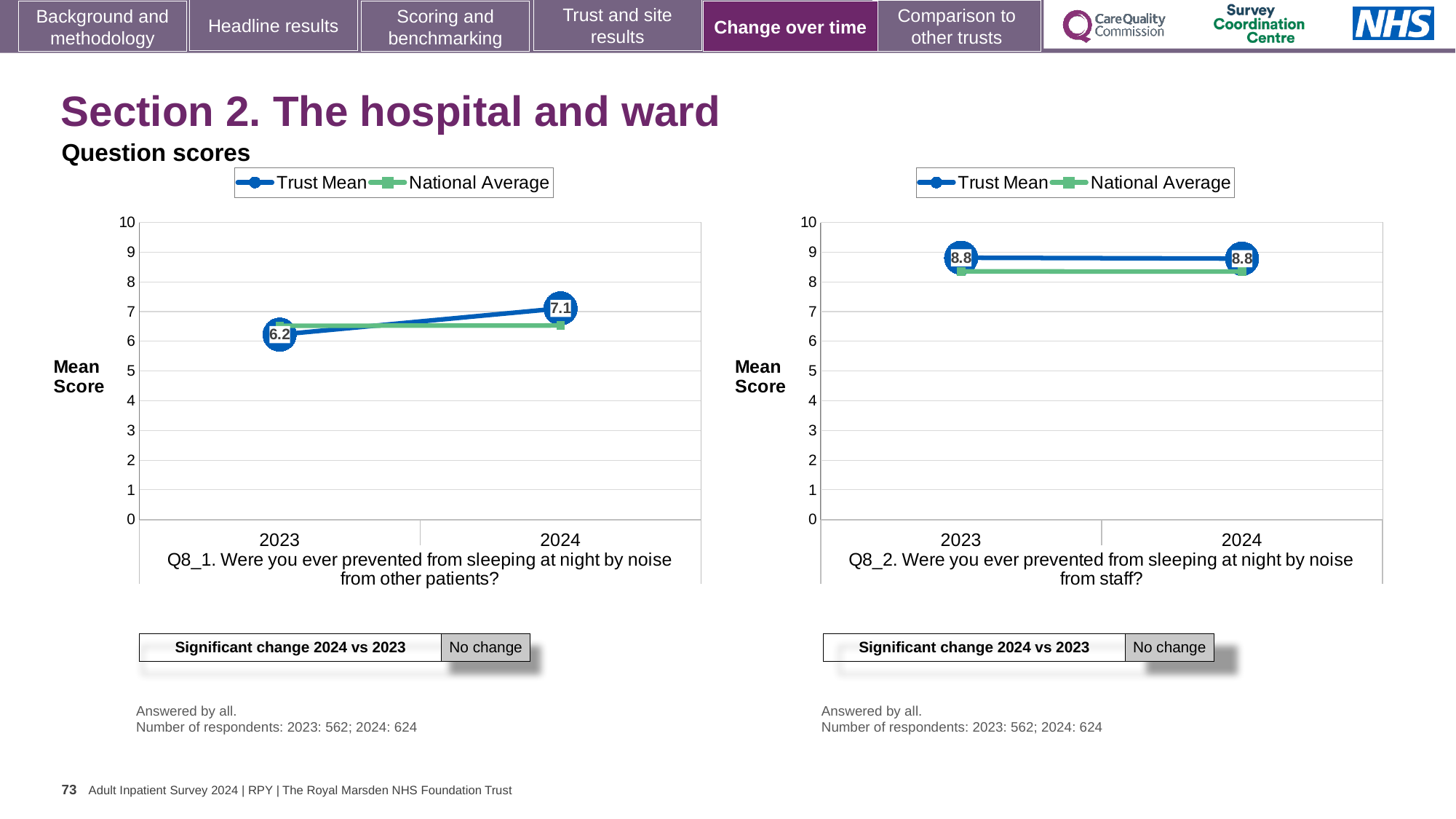
In the Q8_1 chart (left), which is larger in 2024, the Trust Mean or the National Average? Trust Mean How many series does the legend of the Q8_2 chart (right) list? 2 In the Q8_2 chart (right), what is the Trust Mean score for 2024? 8.8 In the Q8_1 chart (left), does the Trust Mean rise or fall from 2023 to 2024? rise In the Q8_1 chart (left), what is the Trust Mean score for 2023? 6.2 In the Q8_1 chart (left), is the National Average for 2023 greater or less than 6? greater What kind of chart is the Q8_1 chart (left)? line chart In the Q8_1 chart (left), by how much did the Trust Mean change from 2023 to 2024? 0.9 In the Q8_1 chart (left), what is the Trust Mean score for 2024? 7.1 In the Q8_2 chart (right), does the Trust Mean rise, fall or stay the same from 2023 to 2024? stay the same In the Q8_2 chart (right), is the National Average for 2024 greater or less than 9? less How many years are plotted on the x axis of the Q8_1 chart (left)? 2